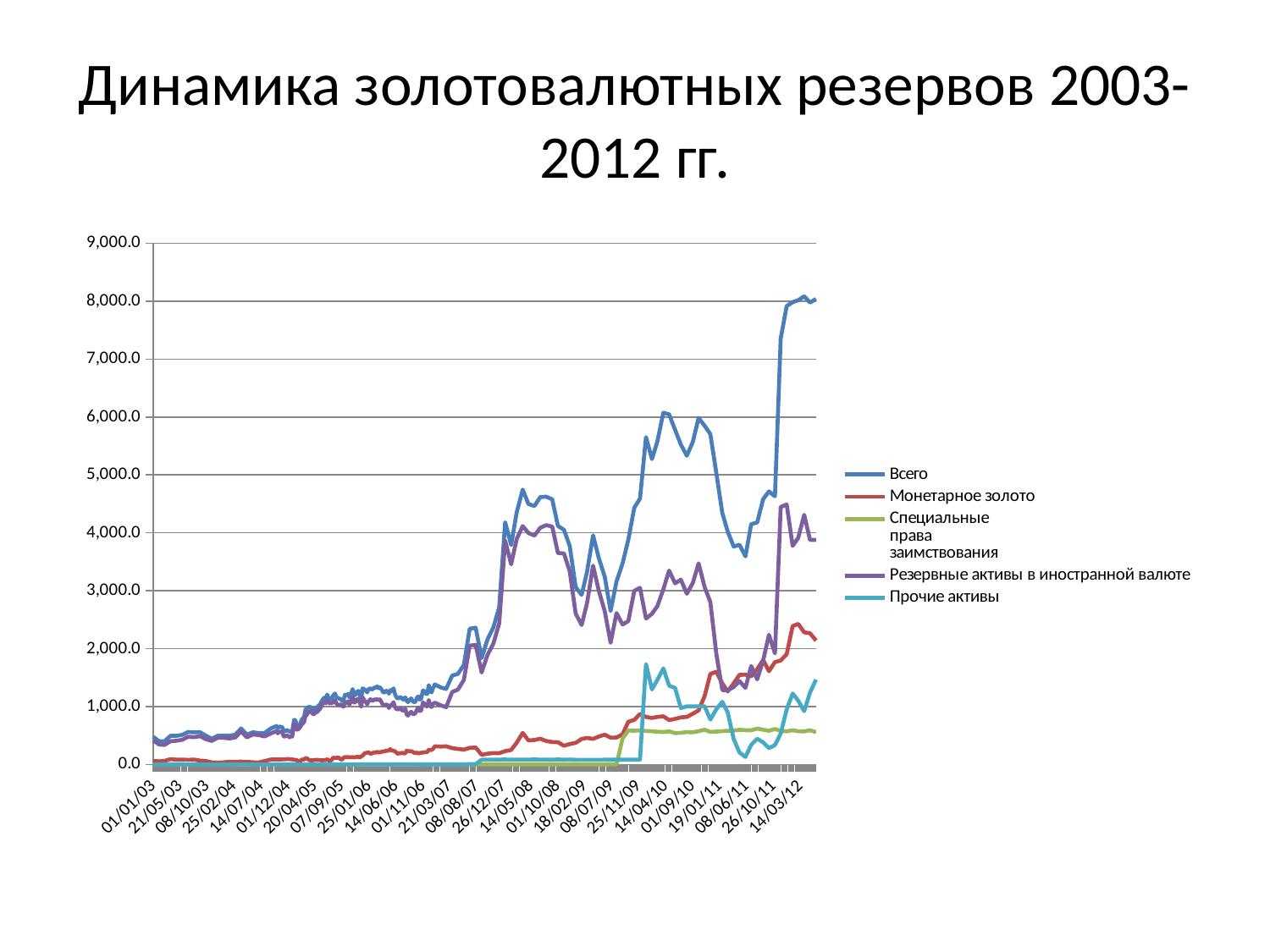
What kind of chart is shown on the slide? line chart Which series is drawn in red in the legend? Монетарное золото Is the value of the Монетарное золото series at 14/03/12 greater or less than 1,000.0? greater At 14/03/12, which is larger: Резервные активы в иностранной валюте or Монетарное золото? Резервные активы в иностранной валюте How many series does the legend list? 5 Is the value of the Всего series at 14/03/12 greater or less than 7,000.0? greater Does the Всего series overall rise or fall from 01/01/03 to 14/03/12? rise Is the value of the Специальные права заимствования series at 14/03/12 greater or less than 1,000.0? less What is the title of the chart on the slide? Динамика золотовалютных резервов 2003-2012 гг. What is the highest value shown on the vertical axis? 9,000.0 Which series reaches the highest value on the chart? Всего